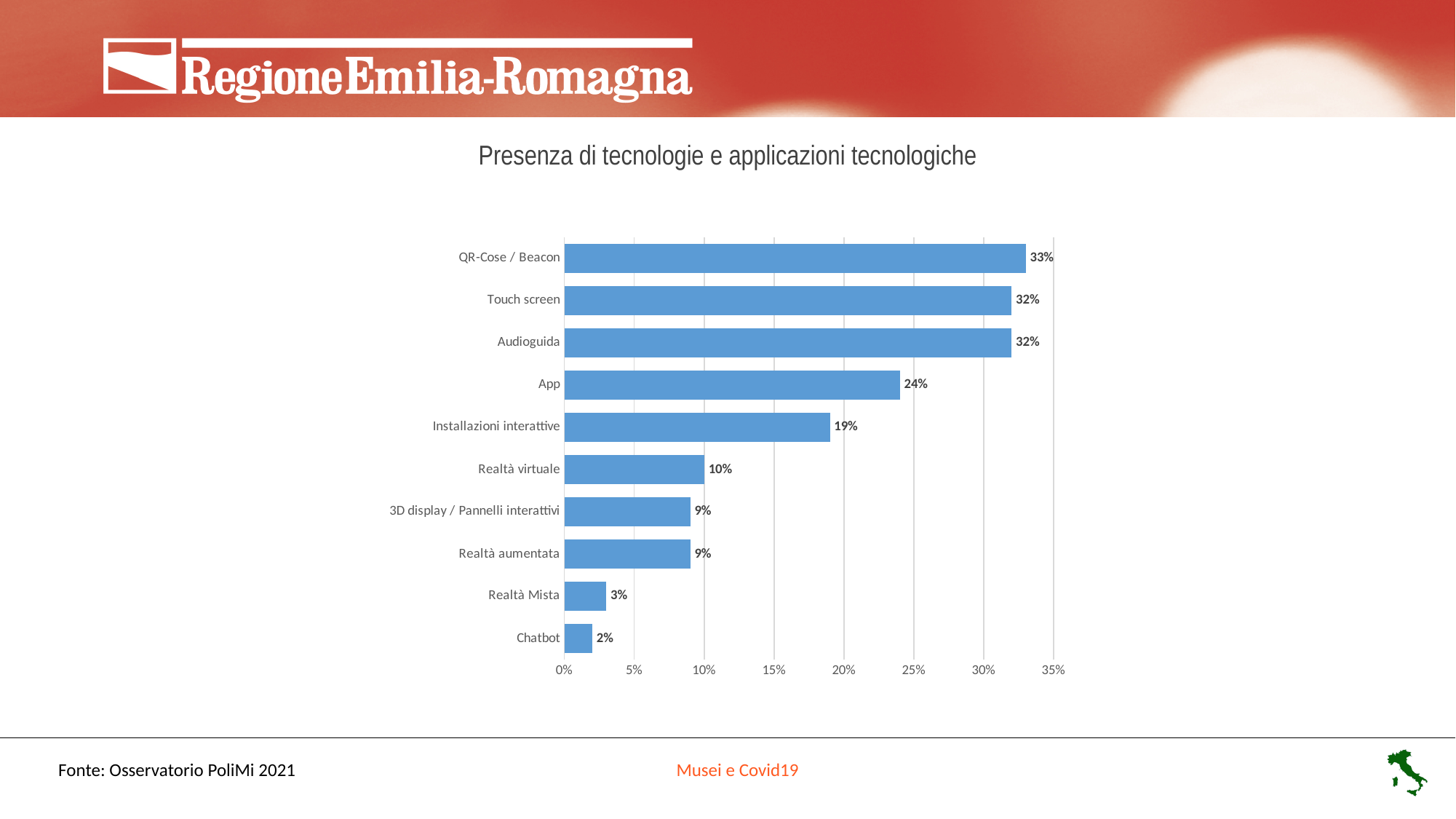
Is the value for Audioguida greater or less than 30%? greater What is the difference between the values for App and Realtà virtuale? 14% What is the value for Installazioni interattive? 19% What is the source cited at the bottom of the slide? Osservatorio PoliMi 2021 What is the value for QR-Cose / Beacon? 33% What is the title of the chart? Presenza di tecnologie e applicazioni tecnologiche Which category has the lowest value? Chatbot How many categories are shown in the chart? 10 Which category has the highest value? QR-Cose / Beacon What kind of chart is shown on the slide? Bar chart Which is larger, the value for Touch screen or the value for App? Touch screen What is the value for Realtà Mista? 3%